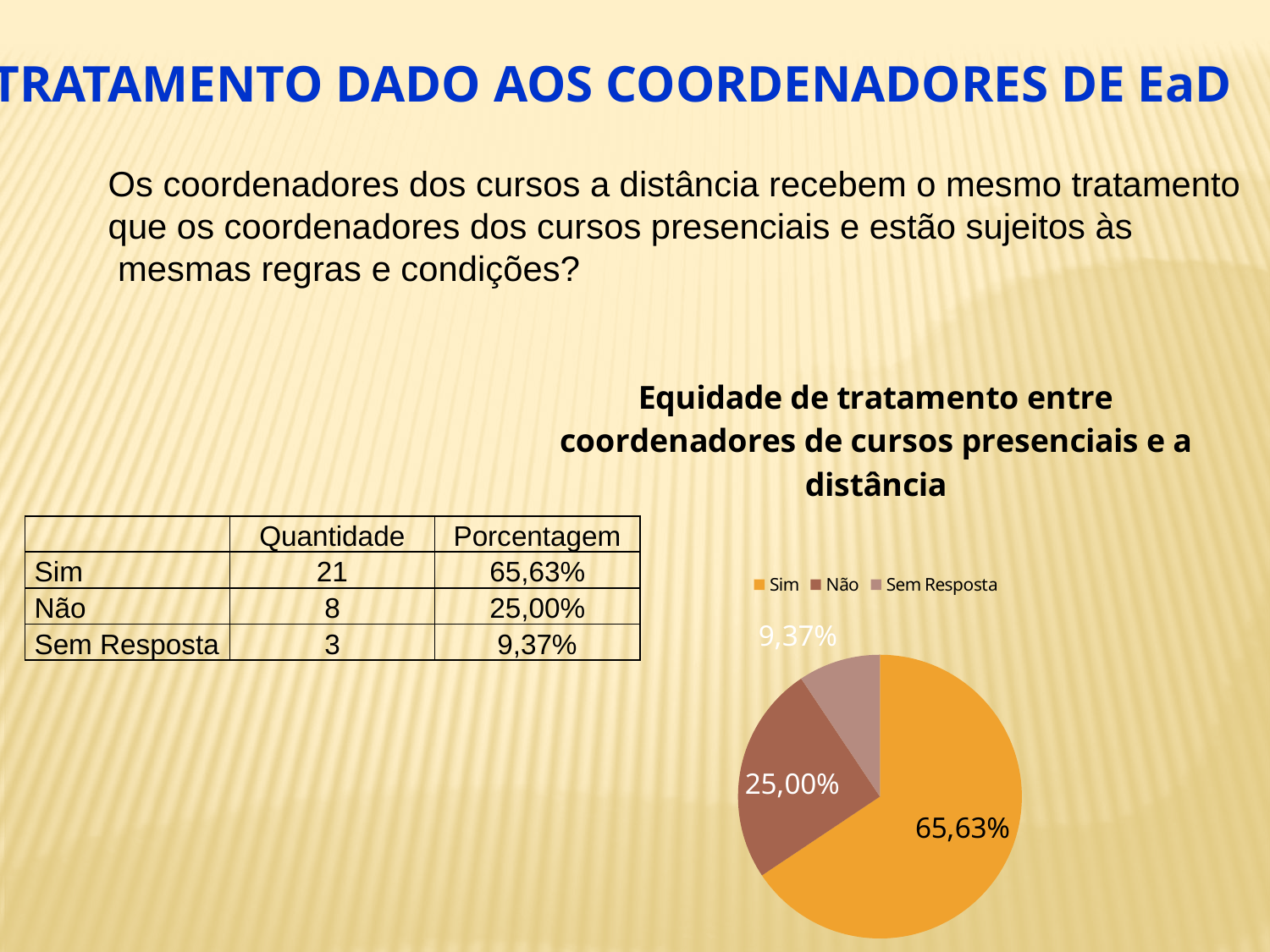
Which slice is larger in the pie chart, 'Não' or 'Sem Resposta'? Não What is the title of the pie chart? Equidade de tratamento entre coordenadores de cursos presenciais e a distância How many entries does the legend of the pie chart list? 3 Which slice of the pie chart is the smallest? Sem Resposta What kind of chart is shown on the slide? pie chart How many slices does the pie chart have? 3 What share of the pie does the 'Não' slice represent? 25,00% What share of the pie does the 'Sim' slice represent? 65,63% Which slice of the pie chart is the largest? Sim What share of the pie does the 'Sem Resposta' slice represent? 9,37% What is the difference in percentage points between the 'Sim' and 'Não' slices? 40,63% Which legend entry is shown in orange in the pie chart? Sim